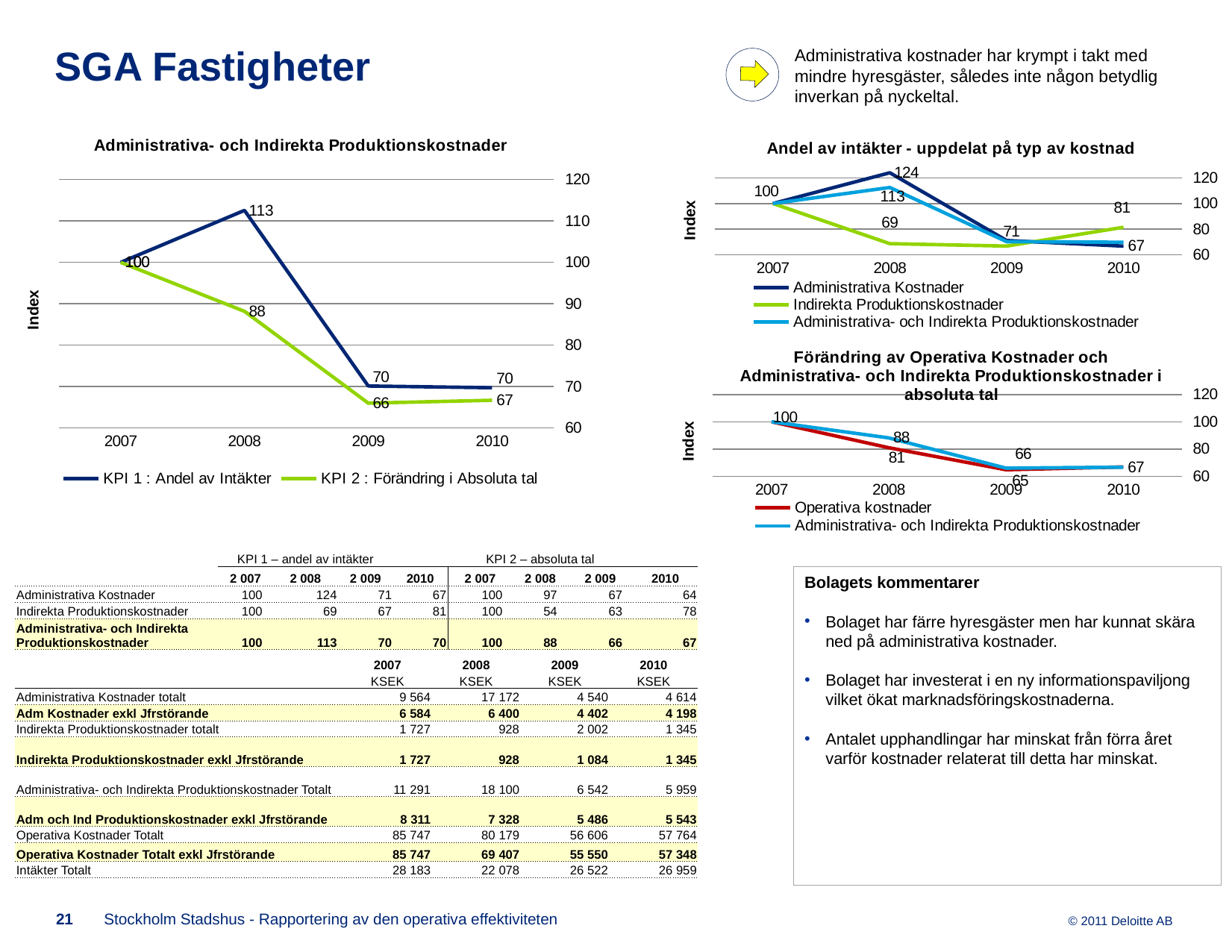
In the chart titled "Andel av intäkter - uppdelat på typ av kostnad", how many series does the legend list? 3 In the chart titled "Administrativa- och Indirekta Produktionskostnader", what is the difference between KPI 1 and KPI 2 in 2008? 25 In the chart titled "Andel av intäkter - uppdelat på typ av kostnad", what is the value of Administrativa Kostnader in 2008? 124 In the chart titled "Andel av intäkter - uppdelat på typ av kostnad", is the value of Indirekta Produktionskostnader in 2008 greater or less than 80? less In the chart titled "Administrativa- och Indirekta Produktionskostnader", in which year is KPI 1 : Andel av Intäkter highest? 2008 What kind of chart is the chart titled "Administrativa- och Indirekta Produktionskostnader"? Line chart In the chart titled "Administrativa- och Indirekta Produktionskostnader", what is the value of KPI 2 : Förändring i Absoluta tal in 2009? 66 In the bottom-right chart ("Förändring av Operativa Kostnader..."), what is the value of Operativa kostnader in 2008? 81 In the chart titled "Andel av intäkter - uppdelat på typ av kostnad", what is the value of Indirekta Produktionskostnader in 2010? 81 In the chart titled "Administrativa- och Indirekta Produktionskostnader", what is the value of KPI 1 : Andel av Intäkter in 2008? 113 In the bottom-right chart ("Förändring av Operativa Kostnader..."), does the Operativa kostnader line rise or fall from 2007 to 2009? Fall In the chart titled "Administrativa- och Indirekta Produktionskostnader", how many series does the legend list? 2